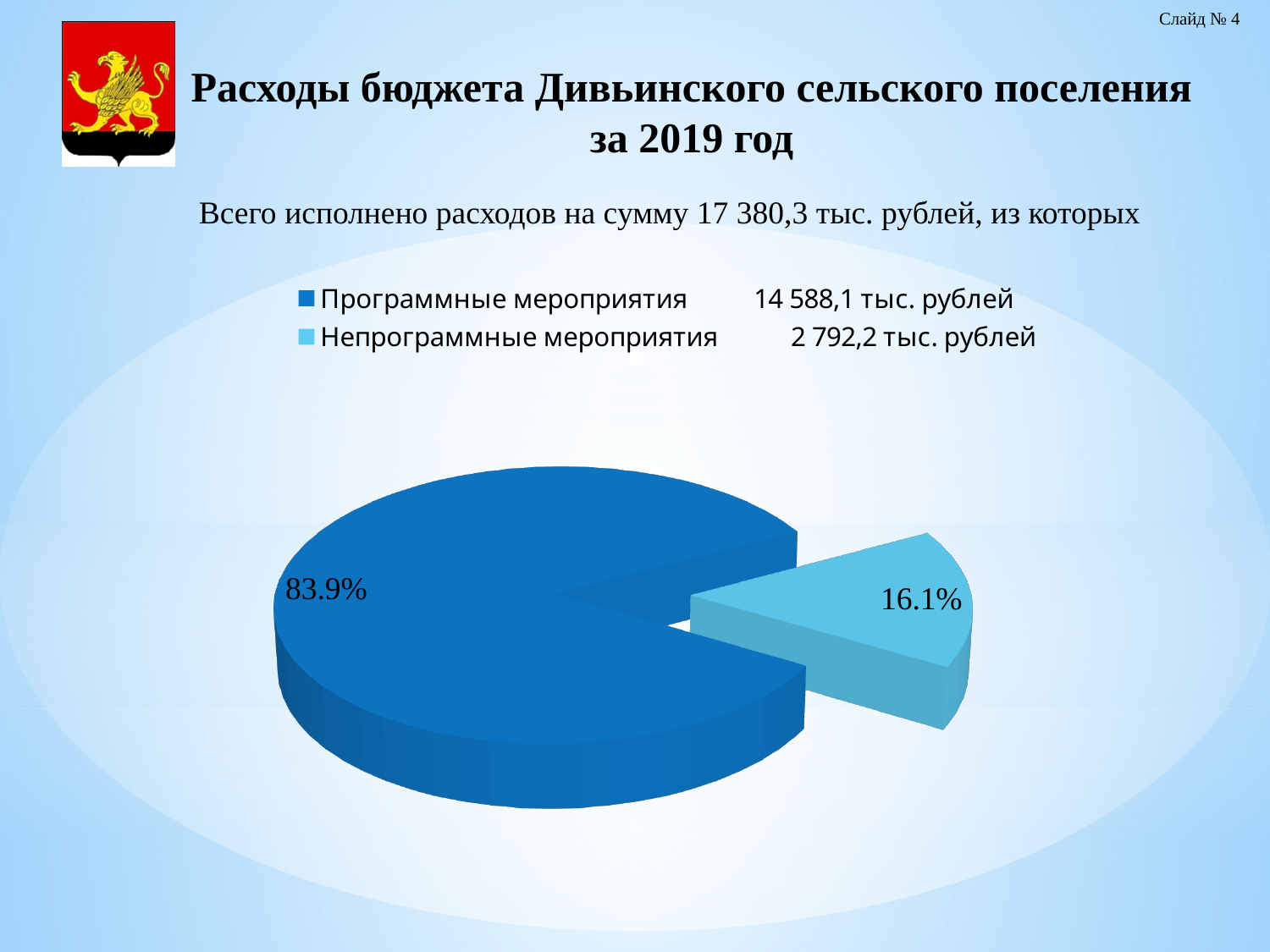
What share of the pie does Непрограммные мероприятия take? 16.1% What kind of chart is shown on the slide? pie chart How many entries does the legend list? 2 What colour is the slice for Непрограммные мероприятия? light blue How many slices does the pie chart have? 2 What amount in тыс. рублей is shown in the legend for Программные мероприятия? 14 588,1 тыс. рублей Which is larger: the slice for Программные мероприятия or the slice for Непрограммные мероприятия? Программные мероприятия Which category has the smallest slice of the pie? Непрограммные мероприятия What is the difference in percentage points between the Программные мероприятия slice and the Непрограммные мероприятия slice? 67.8 Which category has the largest slice of the pie? Программные мероприятия What share of the pie does Программные мероприятия take? 83.9% What amount in тыс. рублей is shown in the legend for Непрограммные мероприятия? 2 792,2 тыс. рублей